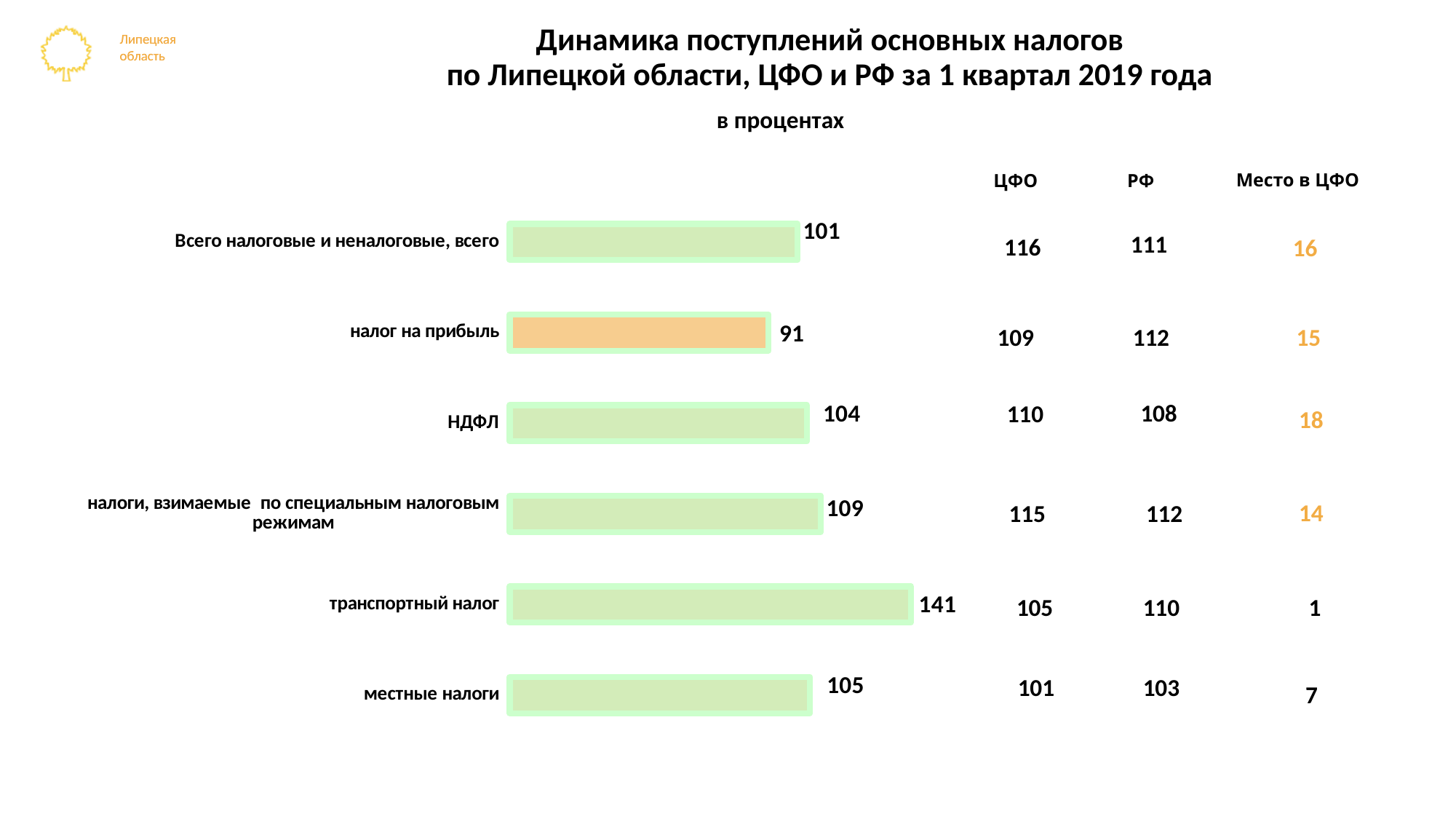
What is the value of the bar for "НДФЛ"? 104 What is the difference between the bar values for "транспортный налог" and "налог на прибыль"? 50 What is the value of the bar for "местные налоги"? 105 Which has a larger bar value: "НДФЛ" or "налоги, взимаемые по специальным налоговым режимам"? налоги, взимаемые по специальным налоговым режимам Which category has the lowest bar value? налог на прибыль How many categories (bars) are shown in the chart? 6 What is the value of the bar for "транспортный налог"? 141 Which category has the highest bar value? транспортный налог What is the value of the bar for "налог на прибыль"? 91 Which bar is coloured differently (orange) from the others? налог на прибыль What is the value of the bar for "Всего налоговые и неналоговые, всего"? 101 What kind of chart is shown on the slide? bar chart